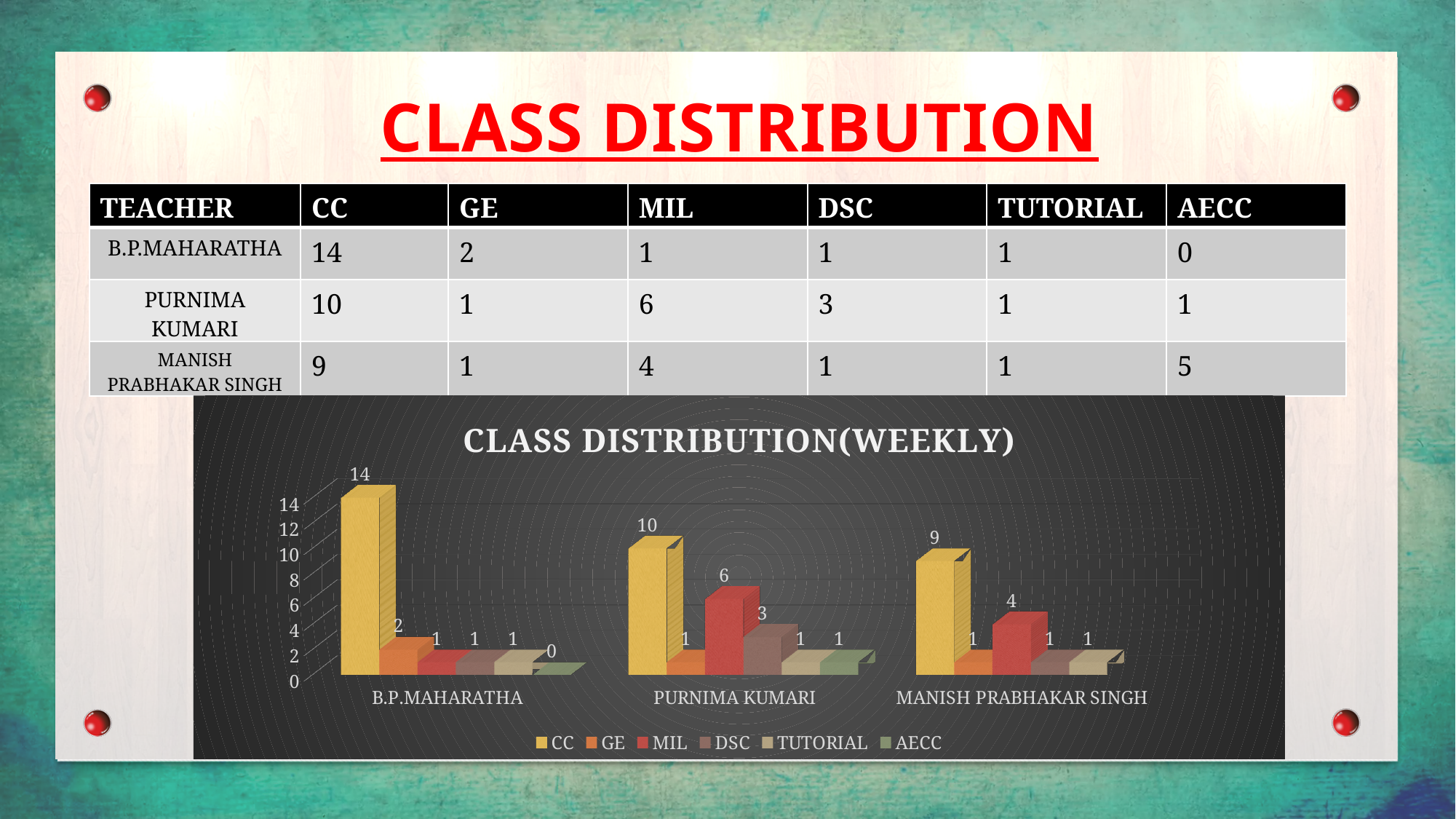
What kind of chart is shown on the slide? Bar chart What is the MIL value for PURNIMA KUMARI in the chart? 6 What is the CC value for MANISH PRABHAKAR SINGH in the chart? 9 Which teacher has the highest CC value in the chart? B.P.MAHARATHA Is the MIL value for PURNIMA KUMARI or for MANISH PRABHAKAR SINGH larger in the chart? PURNIMA KUMARI How many teachers are shown on the x axis of the chart? 3 Which teacher has the lowest CC value in the chart? MANISH PRABHAKAR SINGH What is the CC value for B.P.MAHARATHA in the chart? 14 What is the DSC value for PURNIMA KUMARI in the chart? 3 What is the title of the chart? CLASS DISTRIBUTION(WEEKLY) What is the difference between the CC values of B.P.MAHARATHA and PURNIMA KUMARI in the chart? 4 How many series does the chart legend list? 6